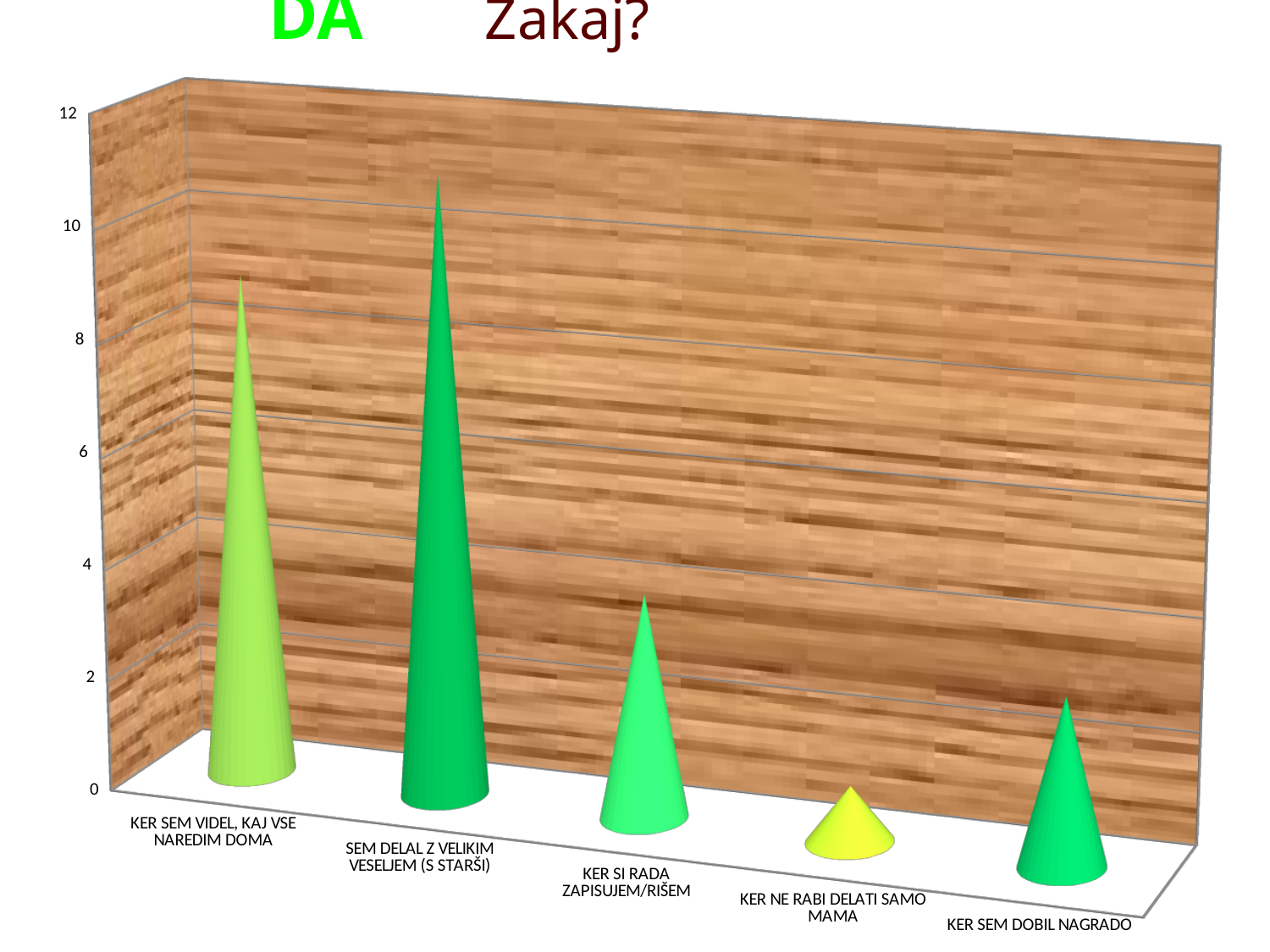
How many categories are shown on the x axis? 5 Is the value for KER SEM DOBIL NAGRADO greater or less than 4? less Which is larger, the value for KER SEM VIDEL, KAJ VSE NAREDIM DOMA or the value for KER SI RADA ZAPISUJEM/RIŠEM? KER SEM VIDEL, KAJ VSE NAREDIM DOMA What is the highest value shown on the vertical axis? 12 Which is larger, the value for KER SEM DOBIL NAGRADO or the value for KER NE RABI DELATI SAMO MAMA? KER SEM DOBIL NAGRADO Which category has the lowest value? KER NE RABI DELATI SAMO MAMA What kind of chart is shown on the slide? bar chart Is the value for SEM DELAL Z VELIKIM VESELJEM (S STARŠI) greater or less than 8? greater Is the value for KER SI RADA ZAPISUJEM/RIŠEM greater or less than 6? less Which category has the highest value? SEM DELAL Z VELIKIM VESELJEM (S STARŠI)